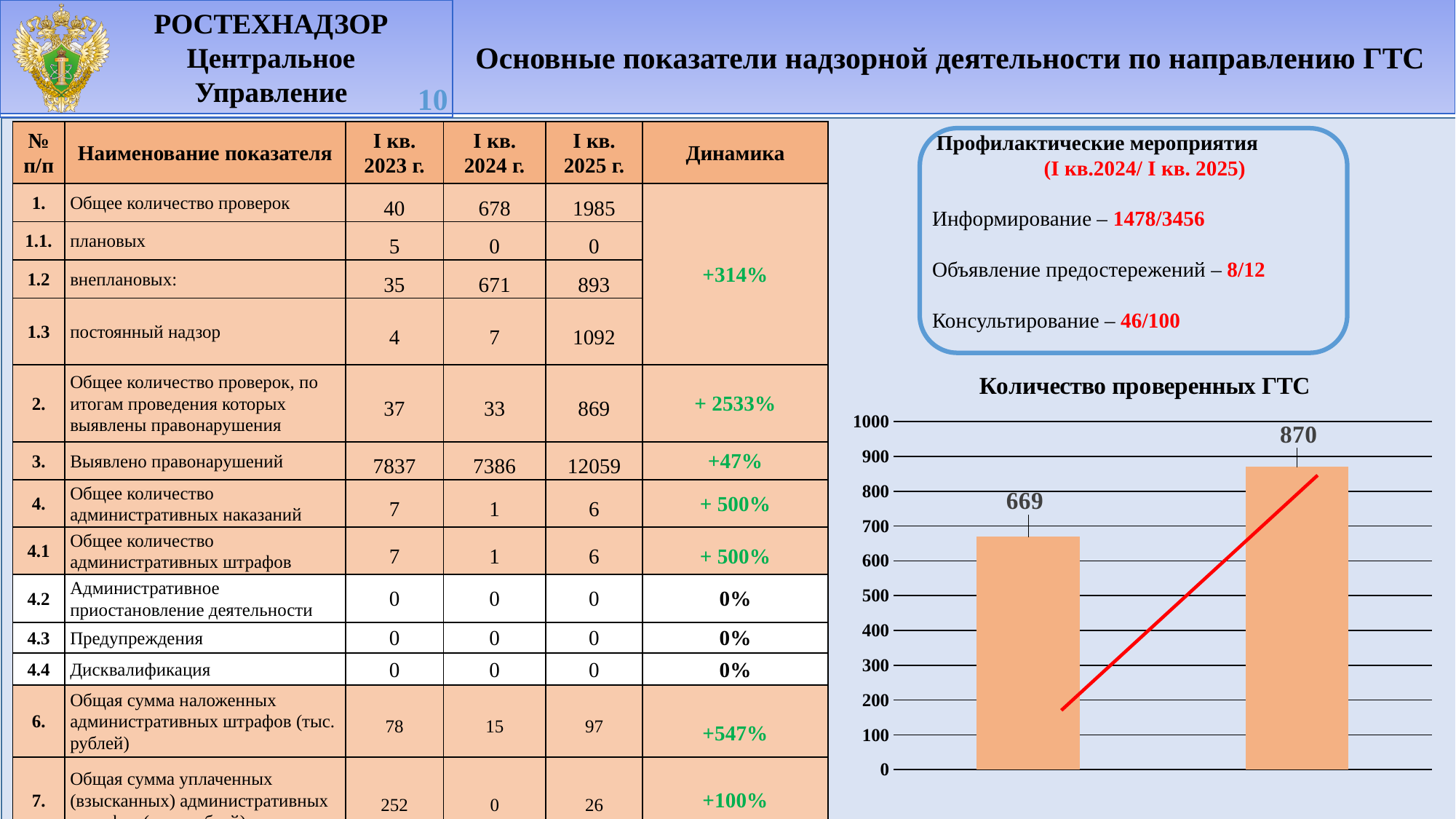
How many bars are plotted in the "Количество проверенных ГТС" chart? 2 In the "Количество проверенных ГТС" chart, what is the difference between the right bar and the left bar? 201 Do the values in the "Количество проверенных ГТС" chart rise or fall from left to right? rise What is the value shown on the right bar of the "Количество проверенных ГТС" chart? 870 In the "Количество проверенных ГТС" chart, which bar is taller, the left one or the right one? the right one What kind of chart is shown under the title "Количество проверенных ГТС"? bar chart What is the highest value plotted in the "Количество проверенных ГТС" chart? 870 In the "Количество проверенных ГТС" chart, is the value of the left bar greater or less than 700? less What is the value shown on the left bar of the "Количество проверенных ГТС" chart? 669 What is the title of the chart on the slide? Количество проверенных ГТС What is the highest tick value on the vertical axis of the "Количество проверенных ГТС" chart? 1000 What is the lowest value plotted in the "Количество проверенных ГТС" chart? 669